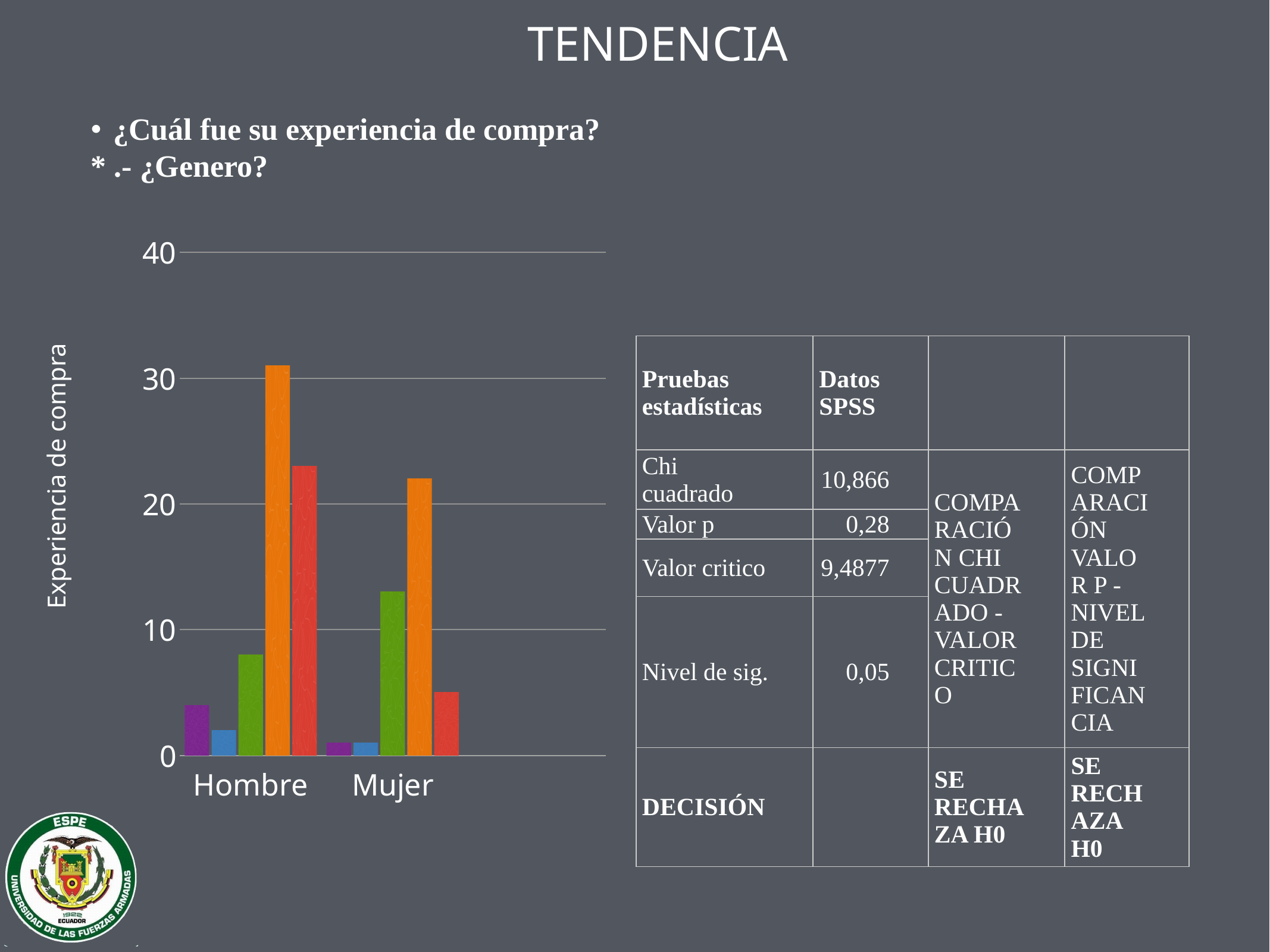
Is the tallest bar for Mujer greater or less than 30? less What is the highest value shown on the vertical axis of the chart? 40 Is the red bar for Mujer greater or less than 10? less How many categories are shown on the x axis of the chart? 2 What kind of chart is shown on the slide? bar chart Is the green bar for Mujer greater or less than 10? greater What is the title of the vertical axis of the chart? Experiencia de compra Which category, Hombre or Mujer, has the tallest bar in the chart? Hombre What are the two categories on the x axis of the chart? Hombre and Mujer How many bars are plotted for the Hombre category? 5